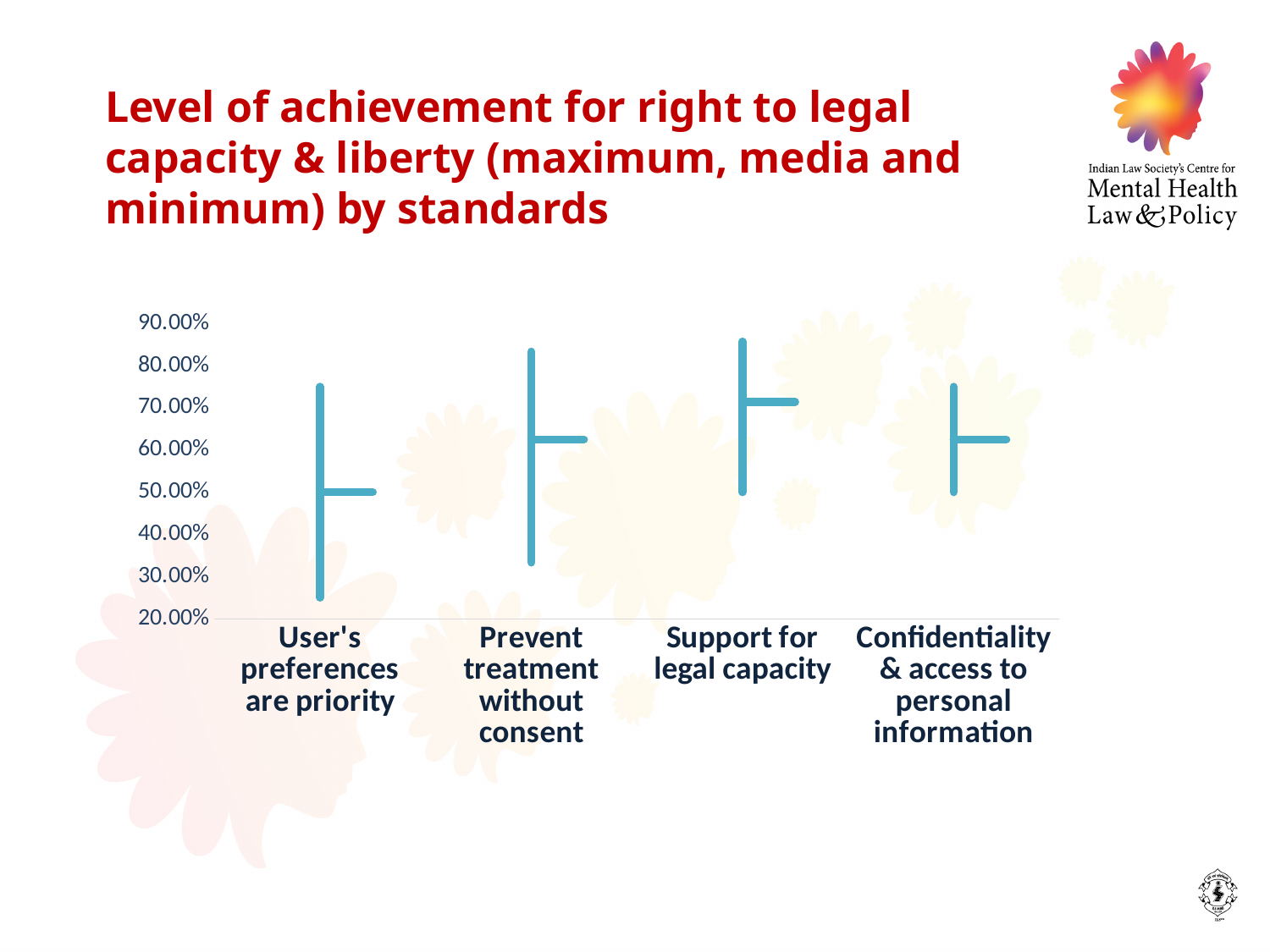
Is the median value for 'Support for legal capacity' greater or less than 60.00%? greater Is the minimum value for 'User's preferences are priority' greater or less than 30.00%? less Is the maximum value for 'Confidentiality & access to personal information' greater or less than 80.00%? less What kind of chart is shown on the slide? A high-low (range) chart showing maximum, median and minimum for each standard Which standard has the highest median value? Support for legal capacity Which has the higher median value: 'User's preferences are priority' or 'Prevent treatment without consent'? Prevent treatment without consent Which standard has the lowest minimum value? User's preferences are priority How many standards (categories) are shown on the x axis of the chart? 4 What is the lowest tick label shown on the vertical axis of the chart? 20.00%